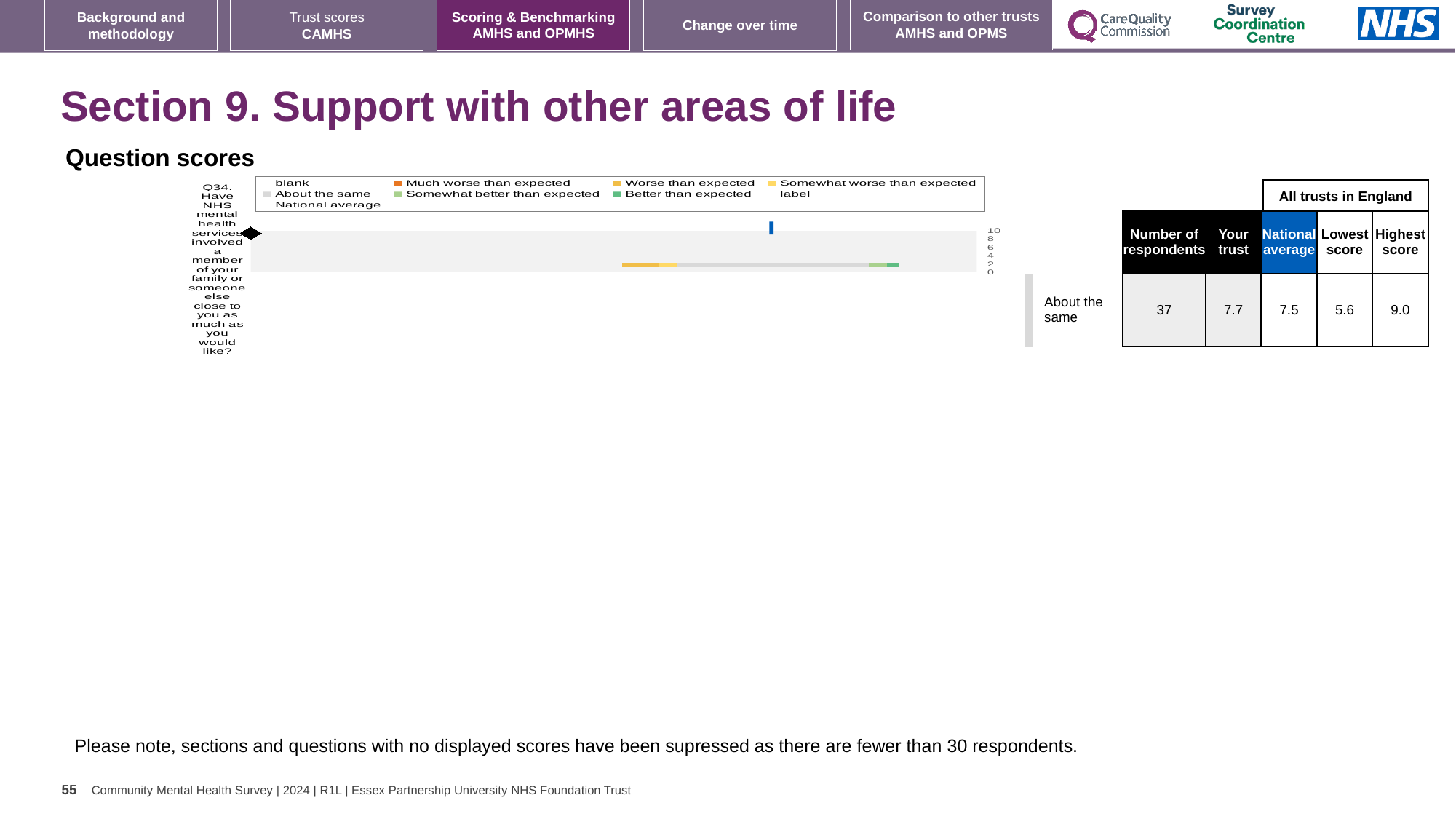
For Q34, which is larger: the 'Your trust' score or the national average? Your trust What is the lowest score among all trusts in England for Q34? 5.6 What kind of chart is used to show the Q34 question score? bar chart What is the 'Your trust' score for Q34? 7.7 What is the national average score for Q34? 7.5 What is the highest score among all trusts in England for Q34? 9.0 What is the difference between the highest and lowest scores for Q34 across all trusts in England? 3.4 By how much does the 'Your trust' score for Q34 exceed the national average? 0.2 How many questions are plotted in the Question scores chart? 1 What is the number of respondents for Q34 shown in the table next to the chart? 37 Which benchmark category is Q34 assigned to, as labelled beside the chart? About the same What is the maximum value shown on the chart's score axis? 10